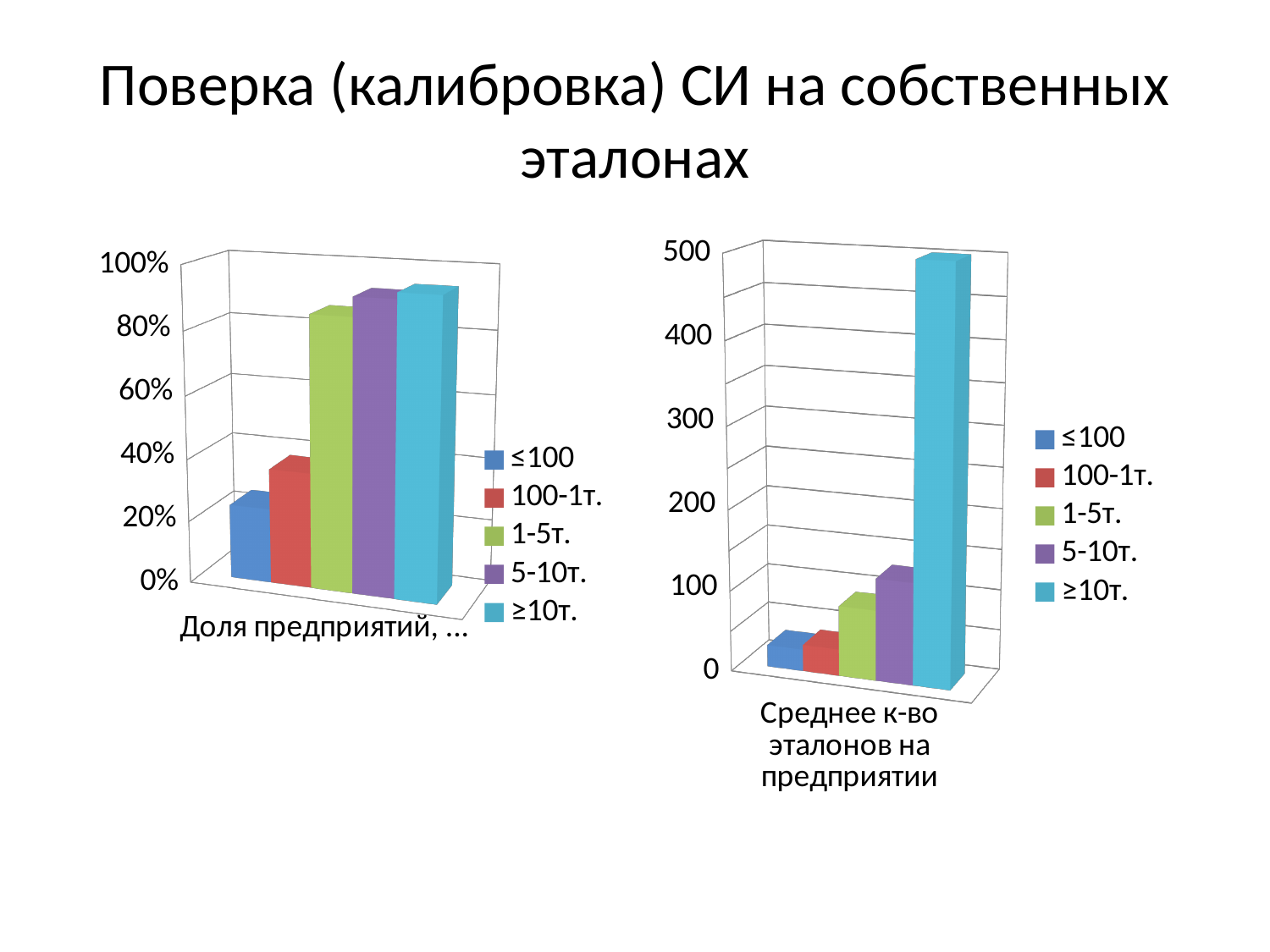
In the right chart (Среднее к-во эталонов на предприятии), which is larger: the value for 5-10т. or the value for ≥10т.? ≥10т. What is the category label on the x axis of the right chart? Среднее к-во эталонов на предприятии In the left chart (Доля предприятий), is the value for 1-5т. greater or less than 60%? greater In the right chart (Среднее к-во эталонов на предприятии), which series has the highest value? ≥10т. In the right chart (Среднее к-во эталонов на предприятии), is the value for ≥10т. greater or less than 400? greater How many series does the legend of the right chart (Среднее к-во эталонов на предприятии) list? 5 How many series does the legend of the left chart (Доля предприятий) list? 5 In the left chart (Доля предприятий), which is larger: the value for 100-1т. or the value for 1-5т.? 1-5т. What kind of chart is the left chart (Доля предприятий)? bar chart In the left chart (Доля предприятий), is the value for ≤100 greater or less than 40%? less In the left chart (Доля предприятий), which series has the lowest value? ≤100